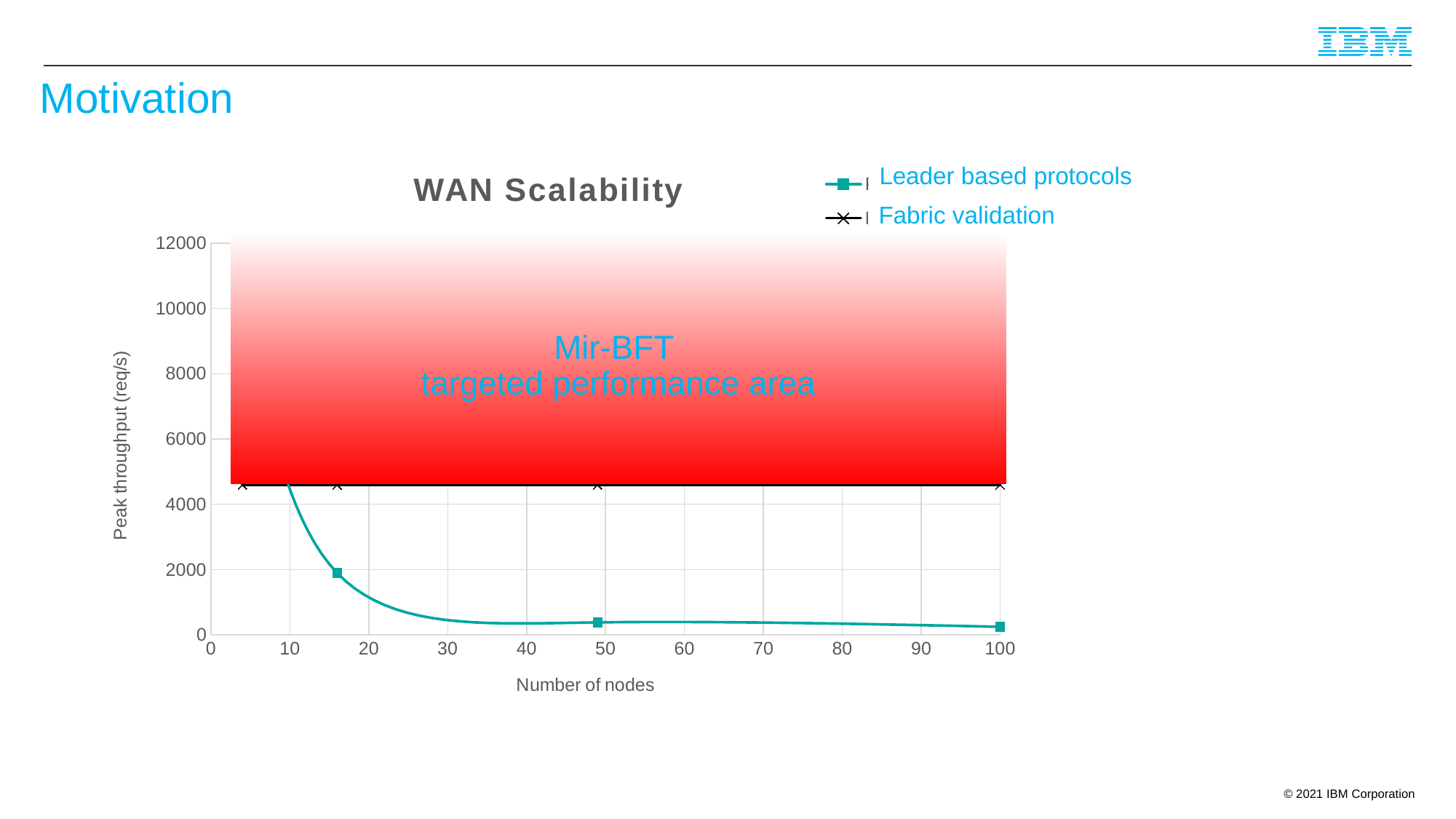
What is the title of the chart? WAN Scalability At 100 nodes, which series has the higher peak throughput, Leader based protocols or Fabric validation? Fabric validation Is the Leader based protocols value at 16 nodes greater or less than 4000? less Does the Leader based protocols series rise or fall as the number of nodes increases? fall Is the Fabric validation value at 100 nodes greater or less than 4000? greater Which series has the lowest peak throughput at 50 nodes? Leader based protocols What kind of chart is shown on the slide? line chart How many series does the chart legend list? 2 What is the label of the x axis? Number of nodes Is the Leader based protocols value at 50 nodes greater or less than 2000? less